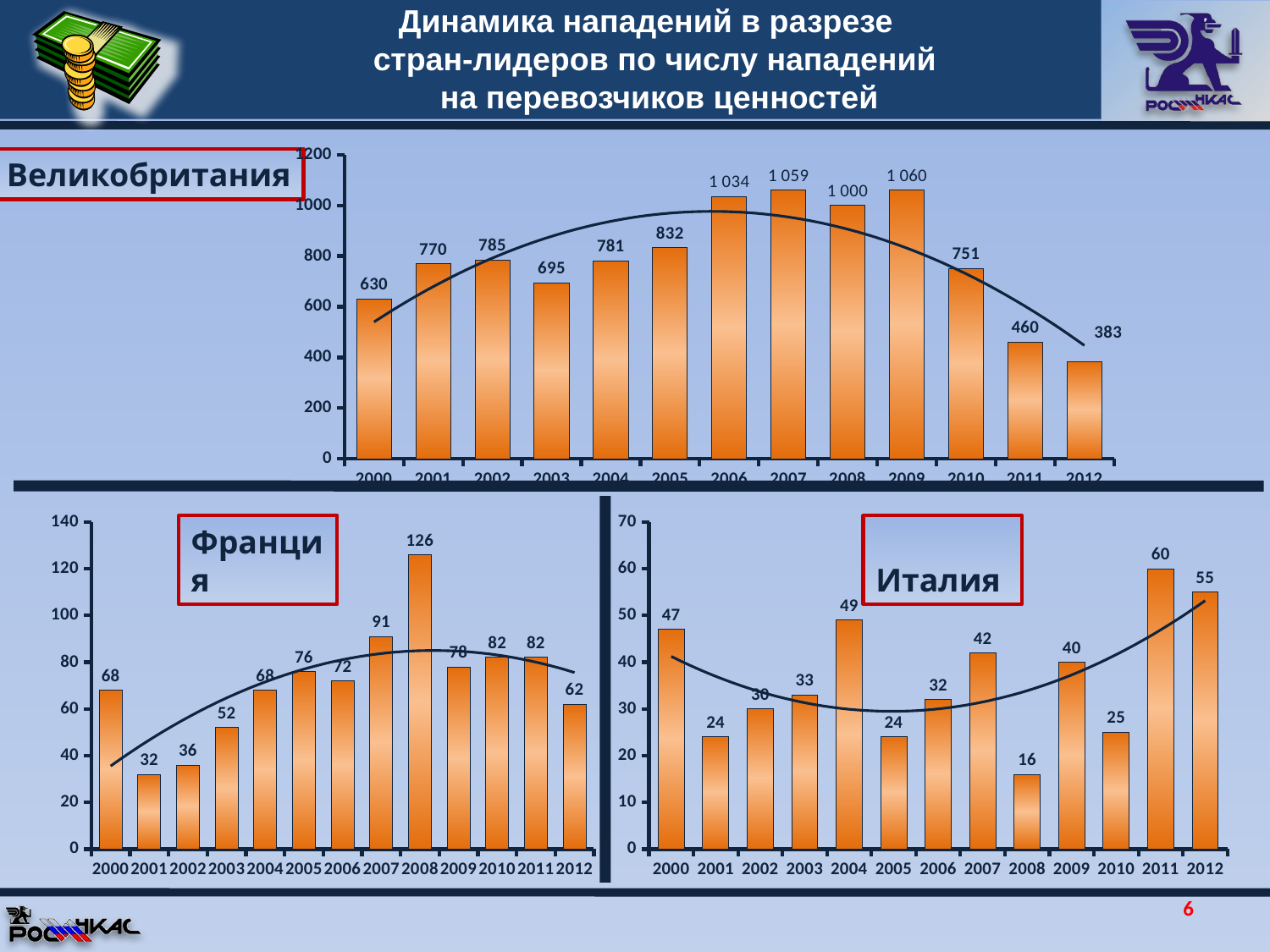
In the Великобритания chart, what is the value for 2012? 383 In the Италия chart, which year has the highest value? 2011 In the Франция chart, which is larger, the value for 2007 or the value for 2009? 2007 How many years are shown on the x axis of the Италия chart? 13 In the Франция chart, which year has the highest value? 2008 In the Италия chart, what is the value for 2008? 16 What kind of chart is the Франция chart? bar chart In the Италия chart, what is the difference between the values for 2011 and 2012? 5 In the Великобритания chart, what is the value for 2009? 1 060 In the Великобритания chart, what is the difference between the values for 2005 and 2000? 202 In the Великобритания chart, which year has the lowest value? 2012 In the Франция chart, what is the value for 2003? 52